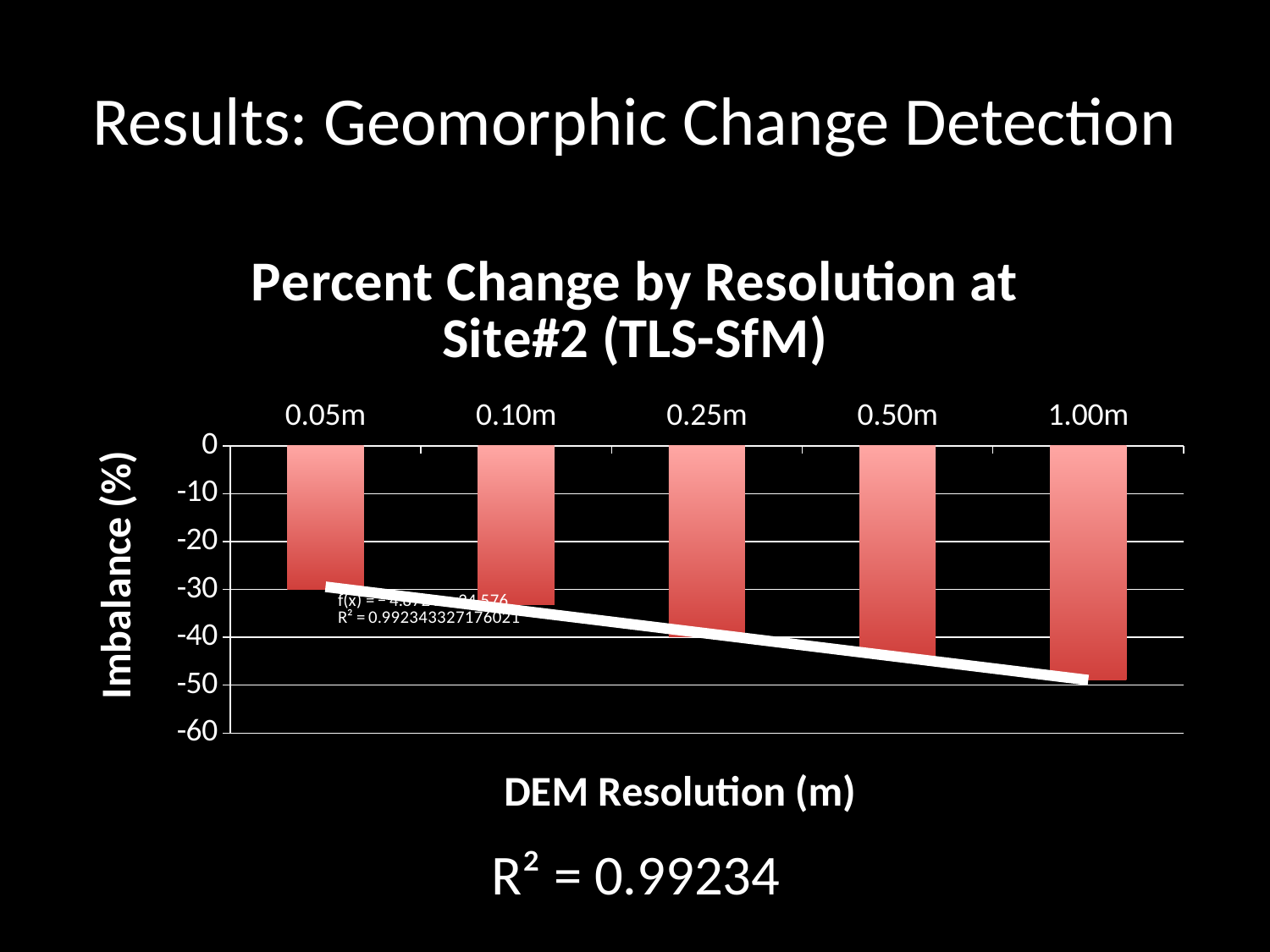
Do the imbalance values rise or fall as DEM resolution increases from 0.05m to 1.00m? fall Which bar is longer (more negative): 0.10m or 0.50m? 0.50m What is the title of the chart? Percent Change by Resolution at Site#2 (TLS-SfM) Is the imbalance value for 0.10m greater or less than -30? less Which bar is longer (more negative): 0.05m or 1.00m? 1.00m Which DEM resolution has the highest (least negative) imbalance value? 0.05m What kind of chart is shown on the slide? bar chart How many DEM resolution categories are plotted in the chart? 5 Which DEM resolution has the lowest (most negative) imbalance value? 1.00m Is the imbalance value for 1.00m greater or less than -40? less Is the imbalance value for 0.05m greater or less than -20? less What is the label of the vertical axis of the chart? Imbalance (%)